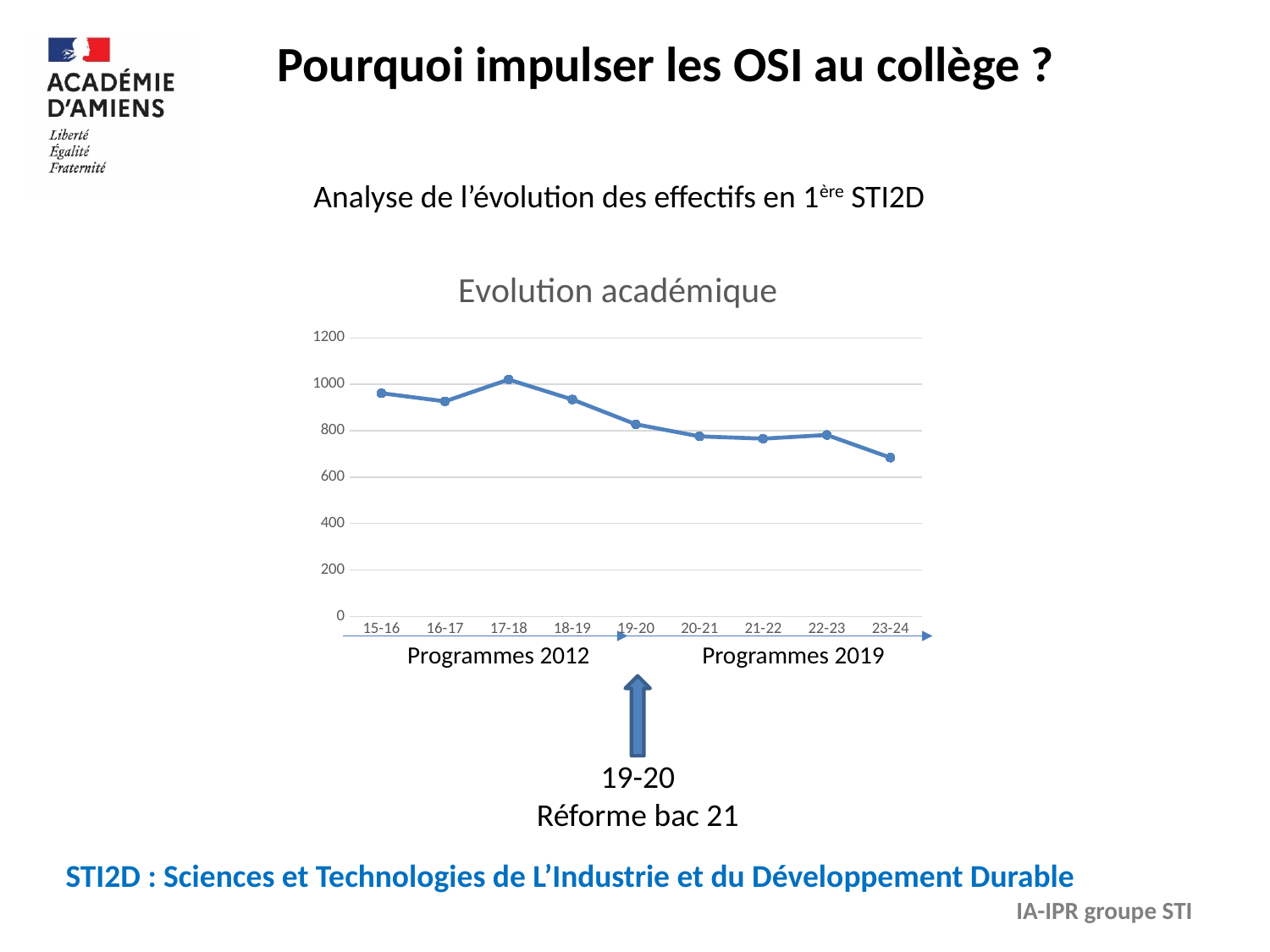
Which school year has the highest value on the chart? 17-18 Is the value for 15-16 greater or less than 1000? less How many data points are plotted on the chart? 9 What is the first category label on the x axis? 15-16 What is the title of the chart? Evolution académique Overall, do the values rise or fall from 15-16 to 23-24? fall What kind of chart is shown on the slide? line chart Is the value for 23-24 greater or less than 800? less Which school year has the lowest value on the chart? 23-24 Is the value for 17-18 greater or less than 1000? greater Which is larger, the value for 18-19 or the value for 19-20? 18-19